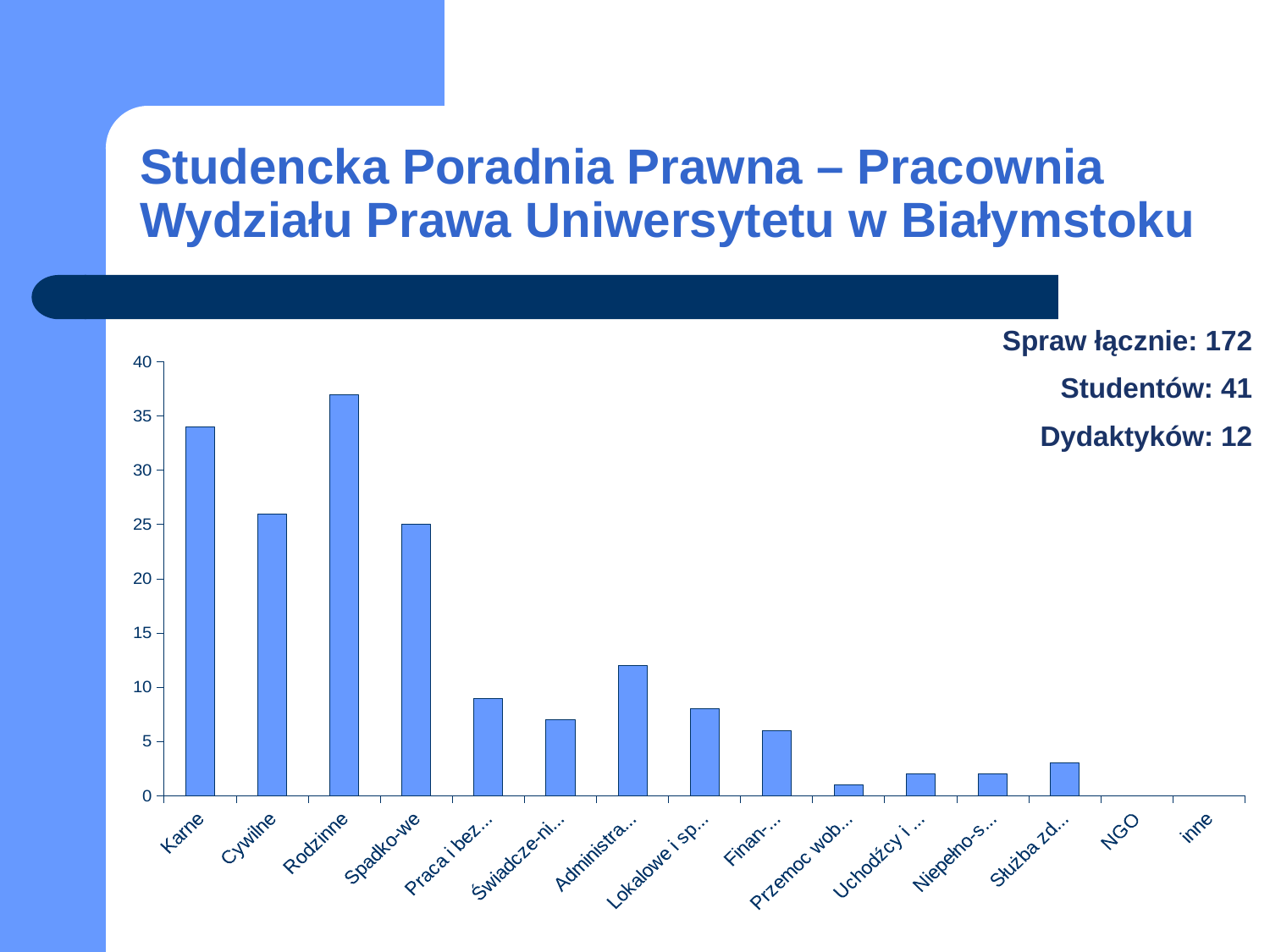
Which is larger, the value for Karne or the value for Cywilne? Karne Is the value for Służba zd... greater or less than 5? less Is the value for Rodzinne greater or less than 35? greater Is the value for Praca i bez... greater or less than 10? less Which category has the highest bar in the chart? Rodzinne What is the value shown for NGO in the chart? 0 How many categories are shown on the x axis of the chart? 15 Which is larger, the value for Administra... or the value for Lokalowe i sp...? Administra... What kind of chart is shown on the slide? bar chart